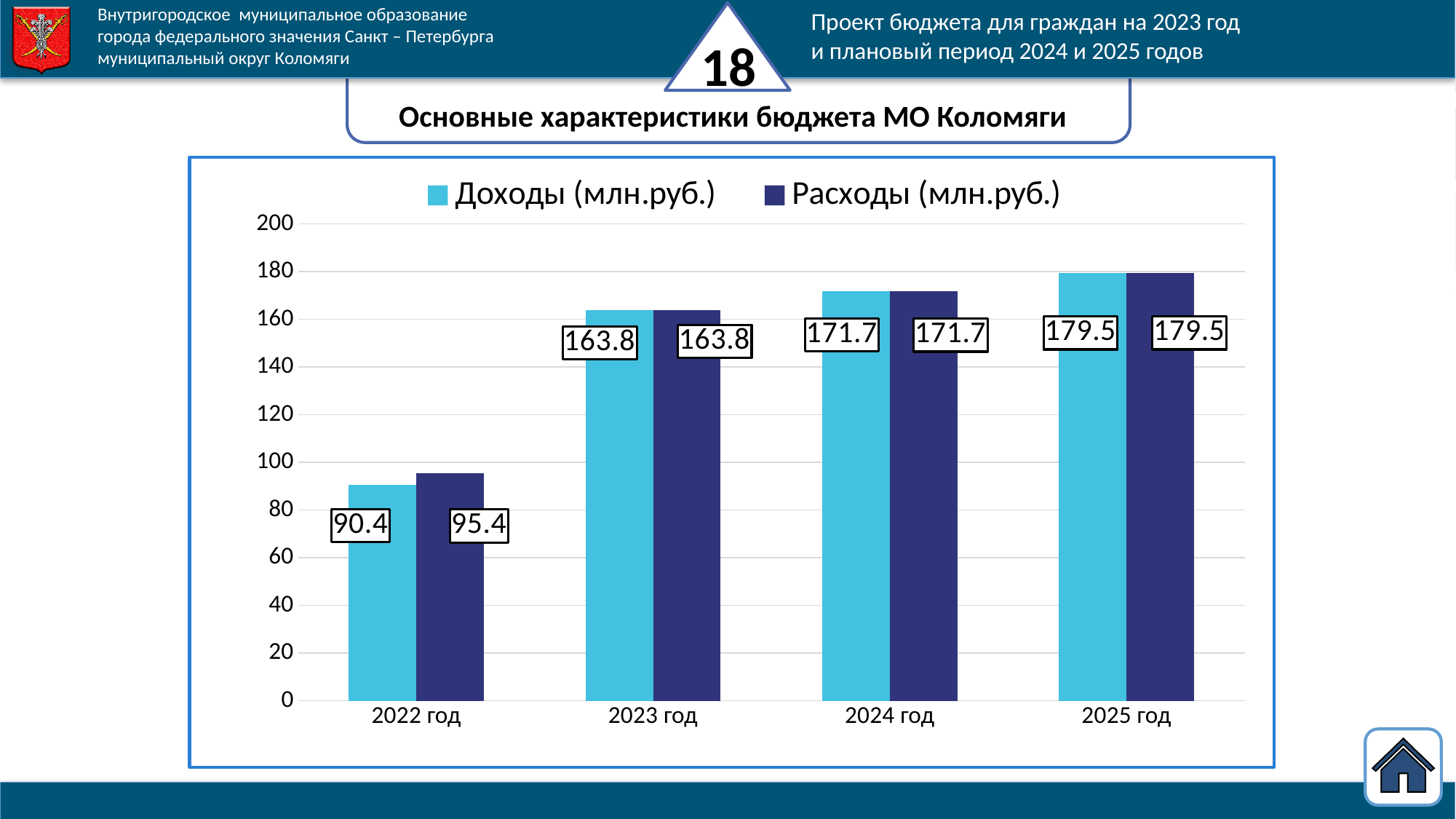
How many years are shown on the x axis? 4 What is the value of Расходы (млн.руб.) for 2025 год? 179.5 Which year has the lowest value for Расходы (млн.руб.)? 2022 год What is the value of Расходы (млн.руб.) for 2022 год? 95.4 Which year has the highest value for Доходы (млн.руб.)? 2025 год How many series does the legend list? 2 Do the values for Доходы (млн.руб.) rise or fall from 2022 год to 2025 год? rise What is the difference between Доходы (млн.руб.) for 2025 год and Доходы (млн.руб.) for 2023 год? 15.7 Which is larger for 2022 год: Доходы (млн.руб.) or Расходы (млн.руб.)? Расходы (млн.руб.) What is the value of Доходы (млн.руб.) for 2022 год? 90.4 What is the difference between Расходы (млн.руб.) and Доходы (млн.руб.) for 2022 год? 5.0 What is the value of Доходы (млн.руб.) for 2024 год? 171.7